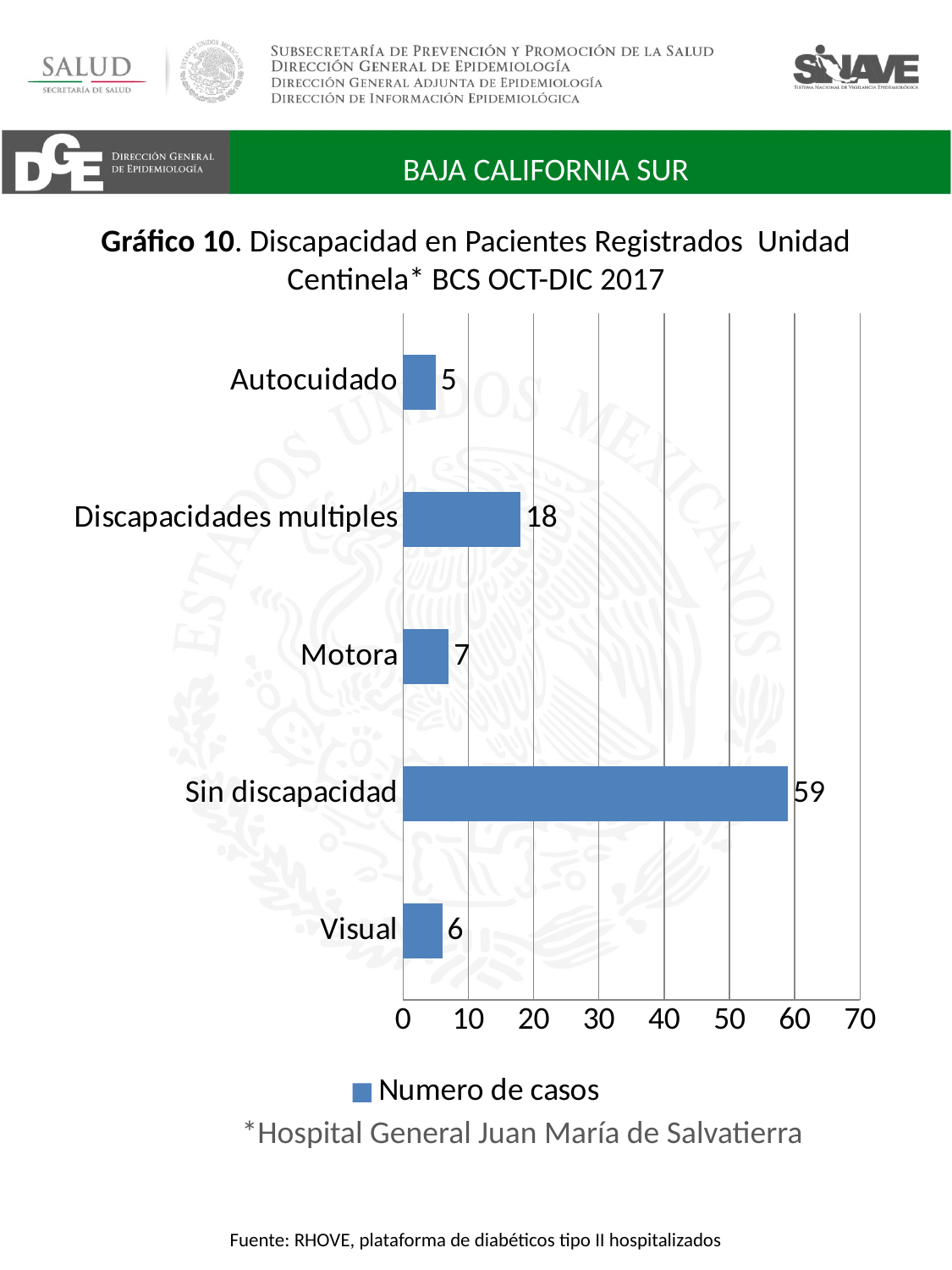
Which category has the lowest number of cases? Autocuidado What kind of chart is shown on the slide? Bar chart What is the number of cases for Discapacidades multiples? 18 What series name does the legend show? Numero de casos What is the difference in number of cases between Sin discapacidad and Discapacidades multiples? 41 What is the number of cases for Visual? 6 What is the number of cases for Motora? 7 What is the number of cases for Sin discapacidad? 59 Which has more cases, Motora or Visual? Motora Is the value for Sin discapacidad greater or less than 50? greater How many categories are shown in the chart? 5 Which category has the highest number of cases? Sin discapacidad